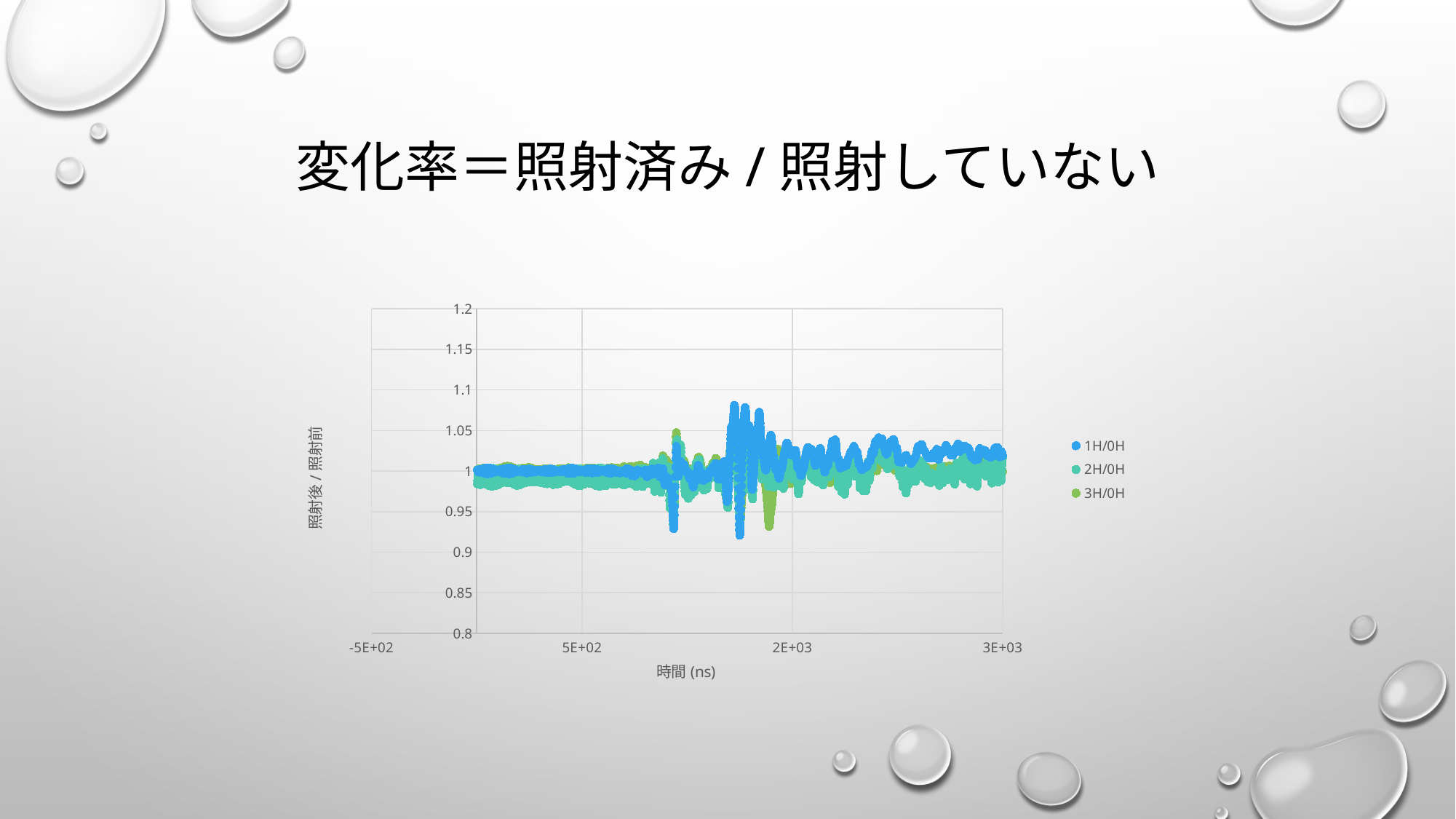
How many series does the legend list? 3 Which series has the highest values near the right end of the x axis (around 3E+03)? 1H/0H What is the label of the x axis? 時間 (ns) What is the highest value shown on the y axis? 1.2 Is the lowest value of the 1H/0H series greater or less than 0.95? less What is the rightmost tick label on the x axis? 3E+03 Are the values of all three series greater or less than 1.1 at the left end of the x axis? less What kind of chart is shown on the slide? scatter chart Is the peak value of the 3H/0H series greater or less than 1.1? less What are the names of the series listed in the legend? 1H/0H, 2H/0H, 3H/0H What is the lowest value shown on the y axis? 0.8